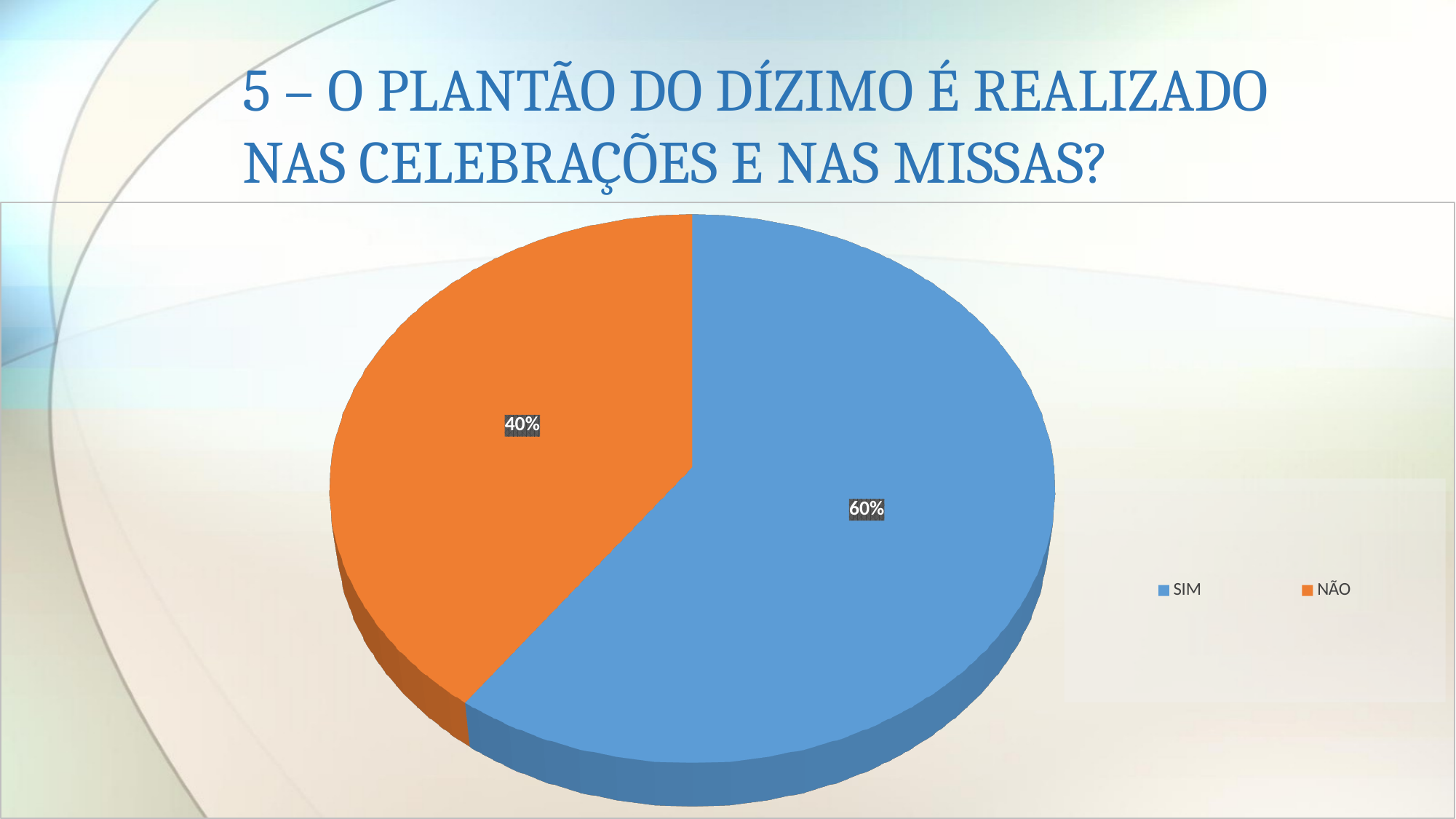
How many entries does the legend list? 2 What kind of chart is shown on the slide? Pie chart What colour is the NÃO slice in the pie chart? Orange What colour is the SIM slice in the pie chart? Blue What percentage of the pie chart is labelled SIM? 60% What share of the pie does the SIM slice represent? 60% Which category has the smallest share of the pie chart? NÃO What percentage of the pie chart is labelled NÃO? 40% Which slice is larger, SIM or NÃO? SIM How many slices does the pie chart have? 2 Which category has the largest share of the pie chart? SIM What is the difference in percentage points between the SIM and NÃO slices? 20